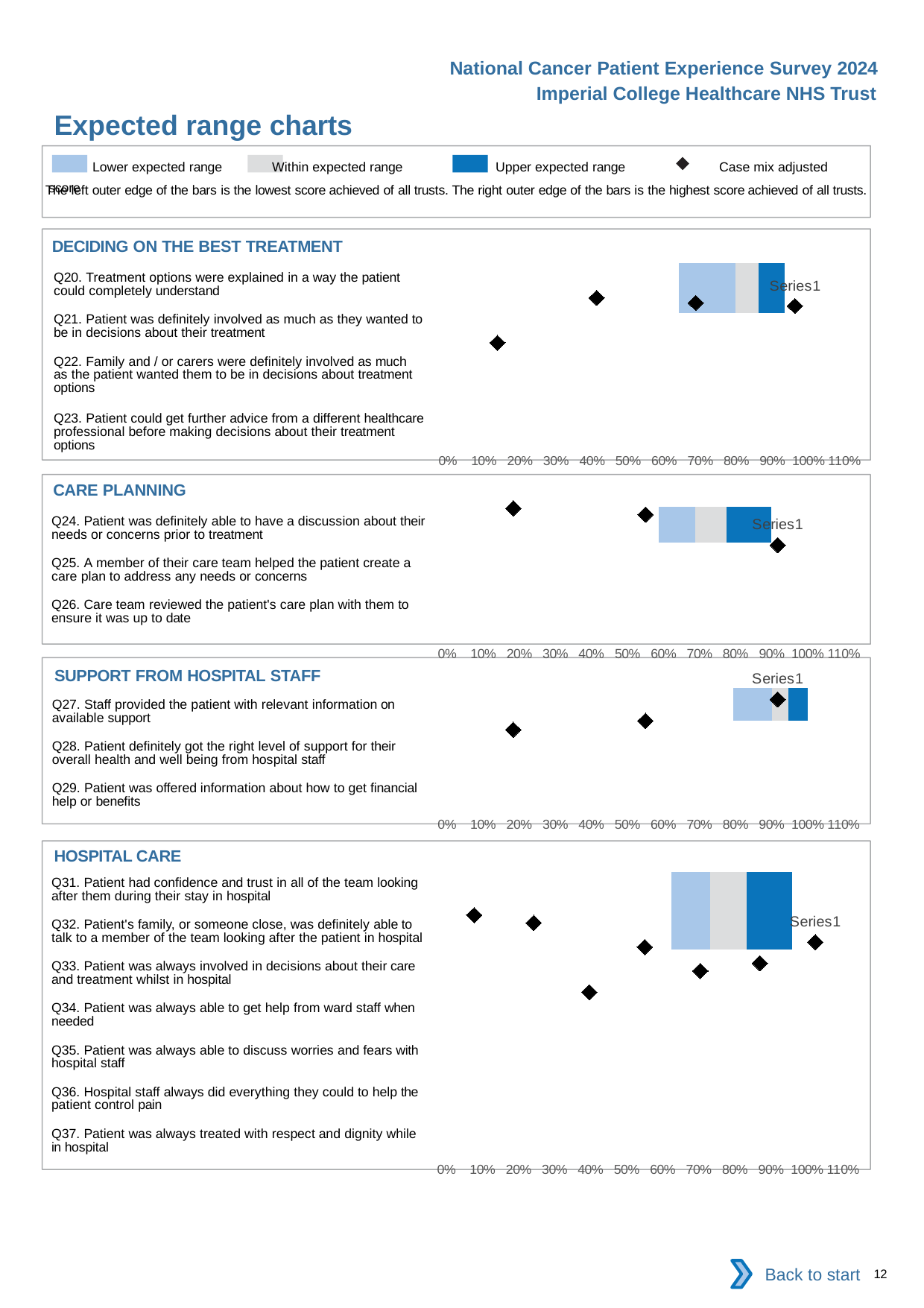
What kind of chart is used in the 'DECIDING ON THE BEST TREATMENT' section? Bar chart Which section chart on the slide has the most questions listed? HOSPITAL CARE How many entries does the legend at the top of the slide list? 4 How many expected range charts are shown on the slide? 4 According to the legend, what does the diamond marker represent? Case mix adjusted score What is the highest tick label shown on the x axis of the 'HOSPITAL CARE' chart? 110% How many questions (categories) are listed in the 'DECIDING ON THE BEST TREATMENT' chart? 4 How many questions (categories) are listed in the 'CARE PLANNING' chart? 3